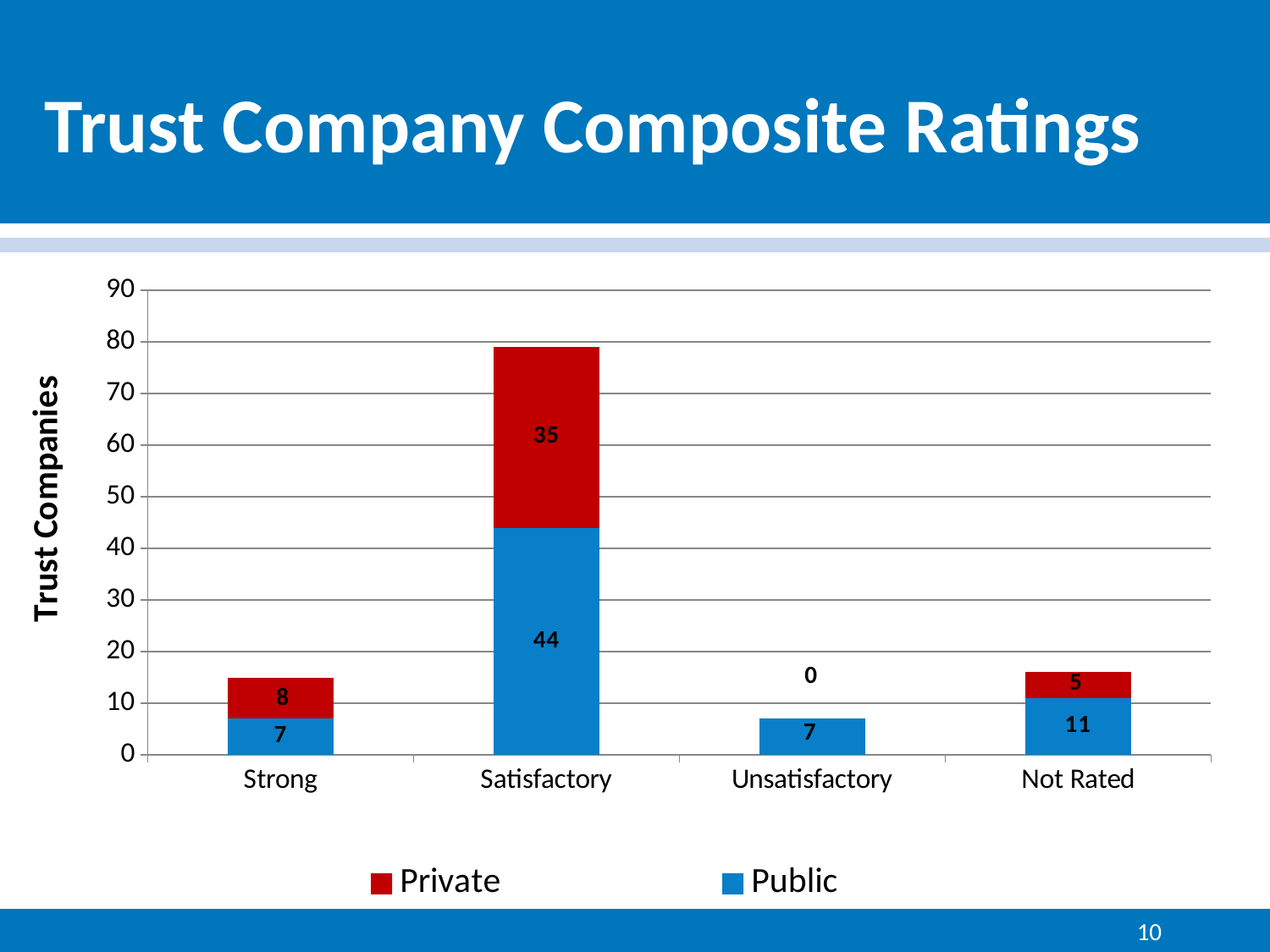
Which category has the highest Public value? Satisfactory How many categories are shown on the x axis? 4 What is the Private value for the Strong category? 8 What is the Private value for the Unsatisfactory category? 0 Which category has the lowest Private value? Unsatisfactory What is the difference between the Public and Private values for the Satisfactory category? 9 How many series does the legend list? 2 What is the Public value for the Not Rated category? 11 What is the Public value for the Satisfactory category? 44 What is the total of the stacked bar for the Satisfactory category? 79 What is the total of the stacked bar for the Not Rated category? 16 Which is larger, the Private value for Strong or the Private value for Not Rated? Private value for Strong